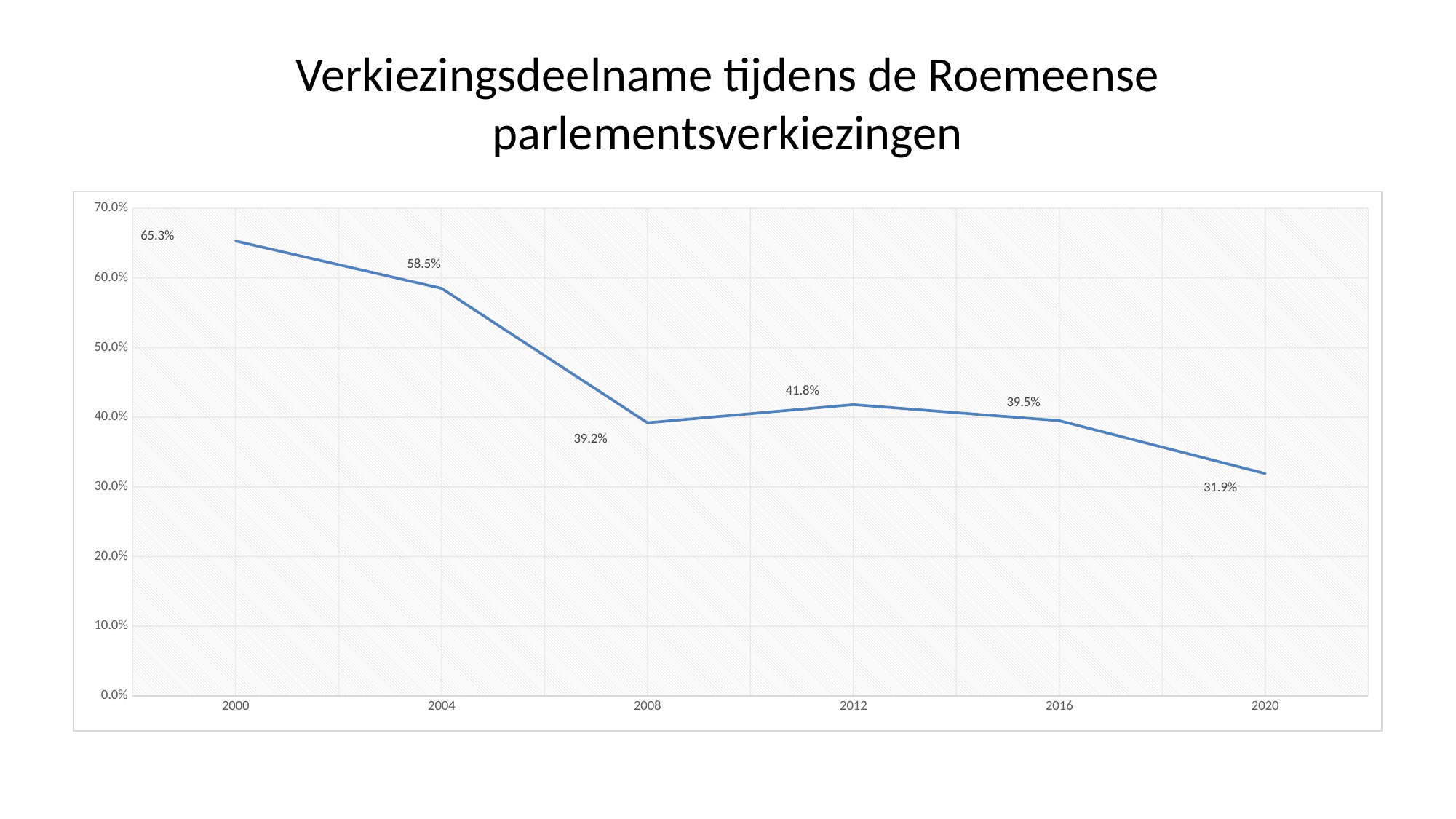
What kind of chart is shown on the slide? line chart What was the election turnout in 2008? 39.2% What was the election turnout in 2000? 65.3% Does the turnout generally rise or fall from 2000 to 2020? fall Is the turnout for 2016 greater or less than 40.0%? less Which year had the highest turnout? 2000 Which year had the lowest turnout? 2020 Which year had a higher turnout, 2008 or 2012? 2012 What is the difference in turnout between 2000 and 2004? 6.8% What was the election turnout in 2020? 31.9% What is the difference in turnout between 2012 and 2020? 9.9% How many election years are plotted on the chart? 6